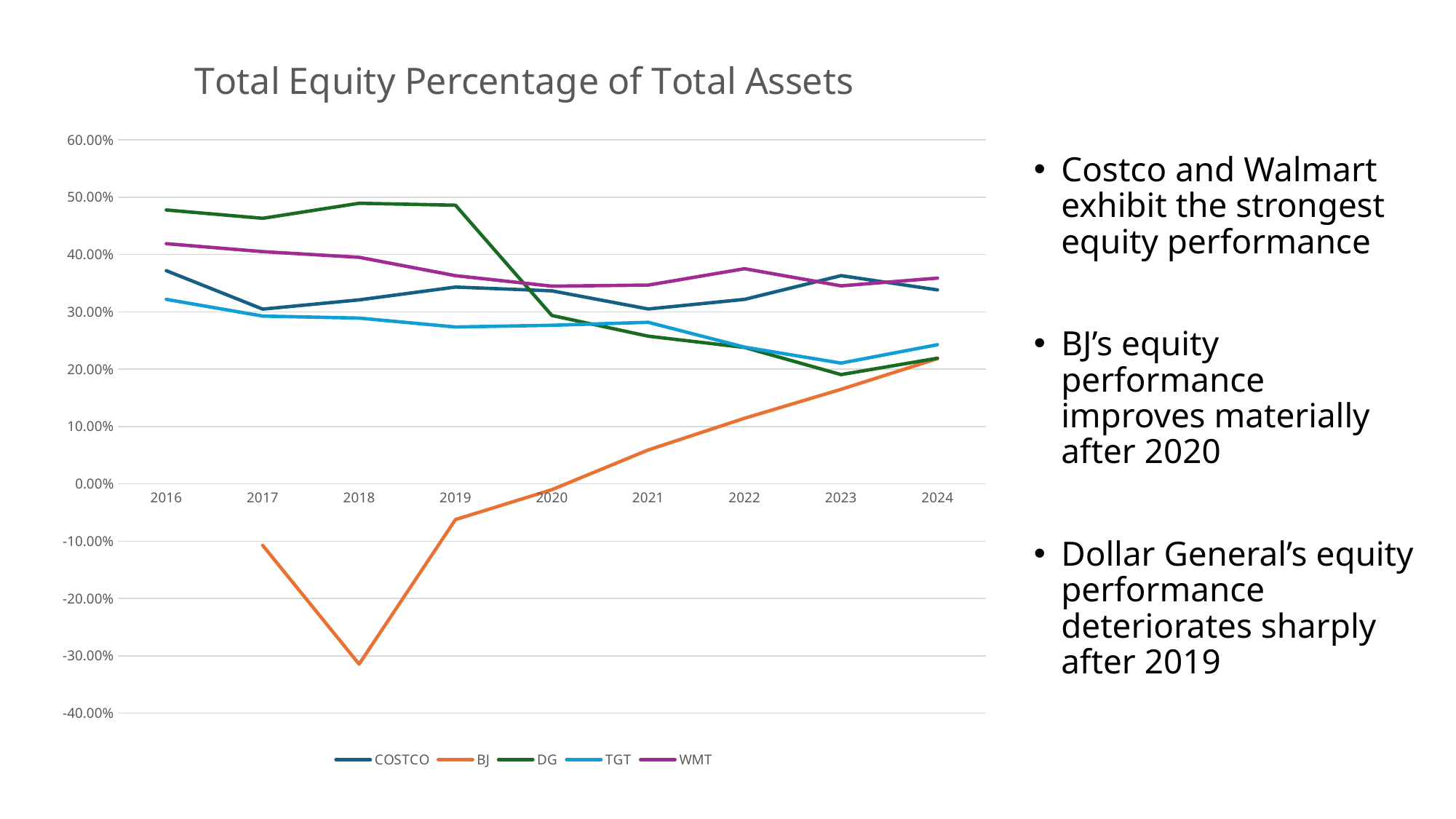
What kind of chart is shown on the slide? line chart Which is larger in 2016, the value for WMT or the value for TGT? WMT Which series has the highest value in 2022? WMT How many series does the legend list? 5 Is the value for TGT in 2023 greater or less than 30.00%? less Does the BJ line rise or fall from 2018 to 2024? rise What is the title of the chart? Total Equity Percentage of Total Assets Which series has the highest value in 2016? DG Is the value for BJ in 2018 greater or less than -20.00%? less How many years are shown on the x axis? 9 Which series has the lowest value in 2018? BJ Is the value for DG in 2019 greater or less than 40.00%? greater